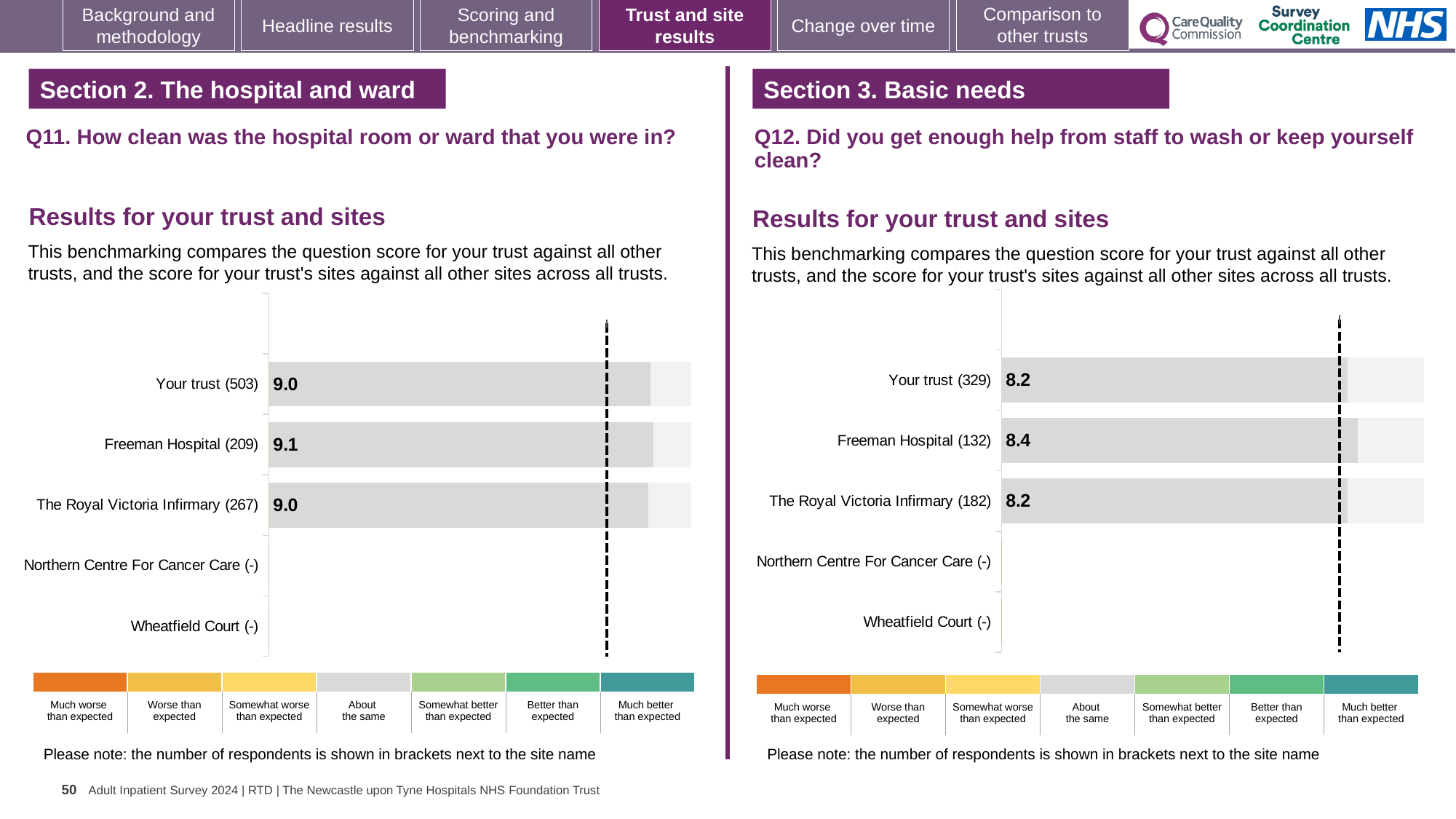
On the Q11 chart (left), what is the difference between the Freeman Hospital score and The Royal Victoria Infirmary score? 0.1 On the Q11 chart (left), what is the score for Freeman Hospital? 9.1 On the Q12 chart (right), what is the score for Freeman Hospital? 8.4 On the Q12 chart (right), what is the score for Your trust? 8.2 On the Q11 chart (left), what is the score for Your trust? 9.0 What kind of chart is used on the Q12 chart (right)? Bar chart On the Q11 chart (left), how many sites or rows are listed on the vertical axis? 5 On the Q11 chart (left), what is the score for The Royal Victoria Infirmary? 9.0 On the Q12 chart (right), what is the score for The Royal Victoria Infirmary? 8.2 On the Q11 chart (left), how many respondents are shown in brackets for Your trust? 503 On the Q12 chart (right), what is the difference between the Freeman Hospital score and the Your trust score? 0.2 On the Q12 chart (right), which site has the highest score? Freeman Hospital